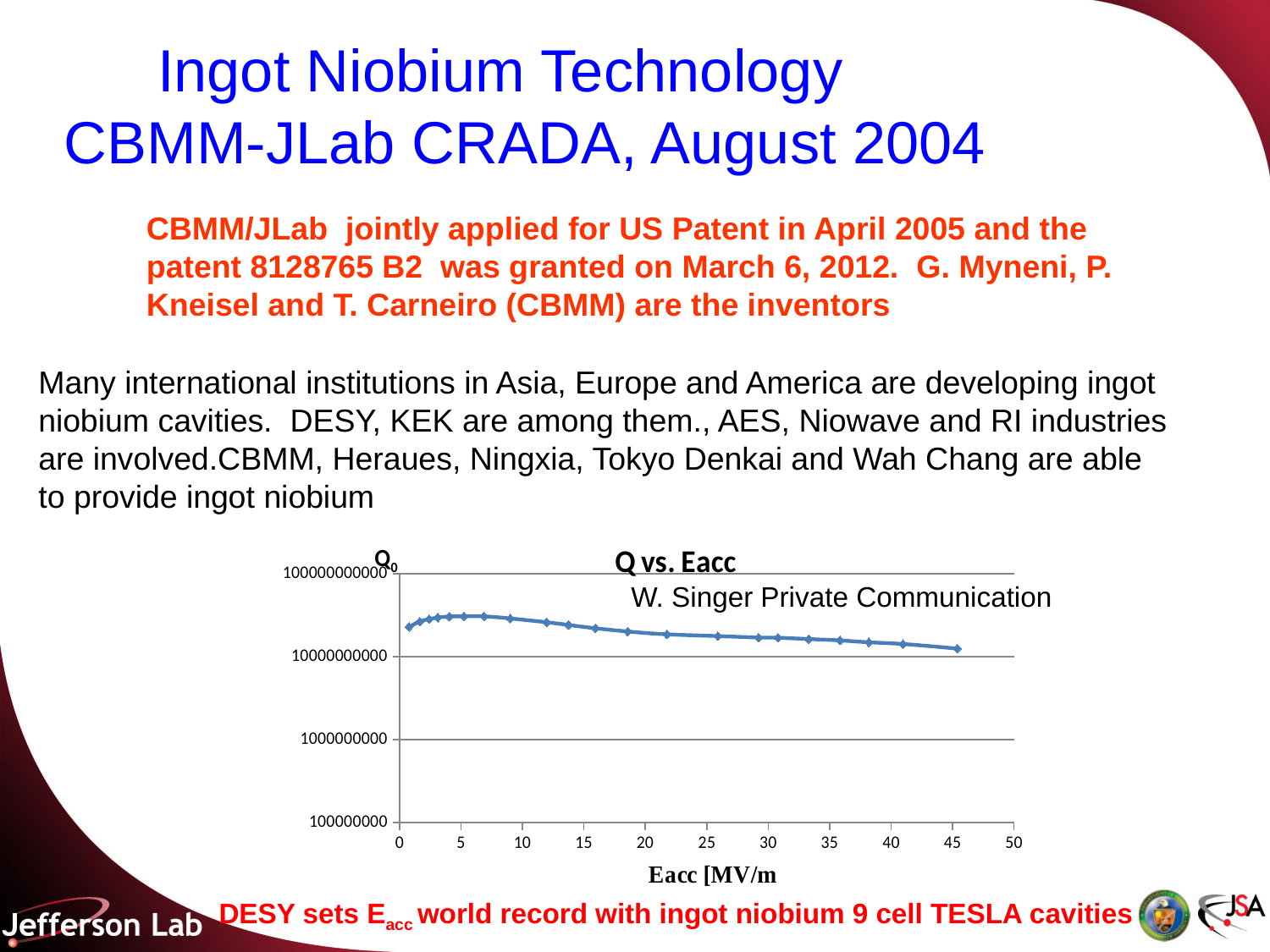
What is the label on the x axis of the chart? Eacc [MV/m What kind of chart is shown on the slide? line chart Which is larger, the Q value at Eacc = 5 or the Q value at Eacc = 40? Eacc = 5 What is the title of the chart? Q vs. Eacc Is the lowest Q value found at the low end or the high end of the Eacc axis? high end Is the Q value at Eacc = 30 greater or less than 1000000000? greater Do the Q values generally rise or fall as Eacc increases along the x axis? fall Is the Q value at Eacc = 5 greater or less than 100000000000? less Is the Q value at Eacc = 20 greater or less than 10000000000? greater Which is larger, the Q value at Eacc = 10 or the Q value at Eacc = 35? Eacc = 10